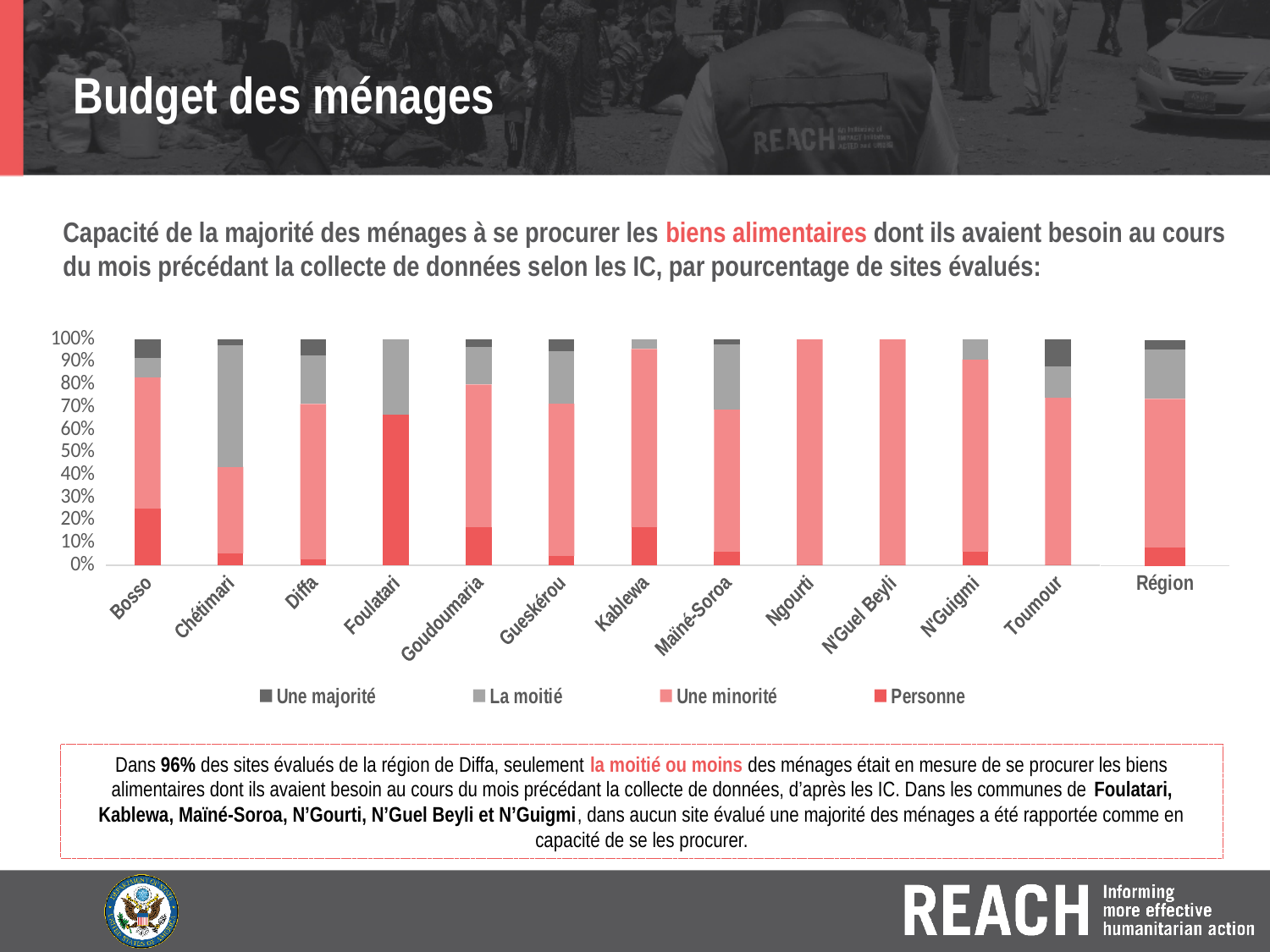
Which two categories consist entirely of the 'Une minorité' series? Ngourti and N'Guel Beyli Which category has the largest 'Personne' segment? Foulatari How many categories are plotted along the x axis of the chart? 13 Which has a larger 'Personne' segment, Bosso or Chétimari? Bosso What kind of chart is shown on the slide? Stacked bar chart What is the total of the stacked bar for Ngourti? 100% Is the 'Personne' value for Région greater or less than 20%? less How many series does the chart legend list? 4 Is the 'Personne' value for Foulatari greater or less than 50%? greater What are the four series named in the chart legend? Une majorité, La moitié, Une minorité, Personne Which category has the largest 'La moitié' segment? Chétimari Is the 'Personne' value for Chétimari greater or less than 10%? less